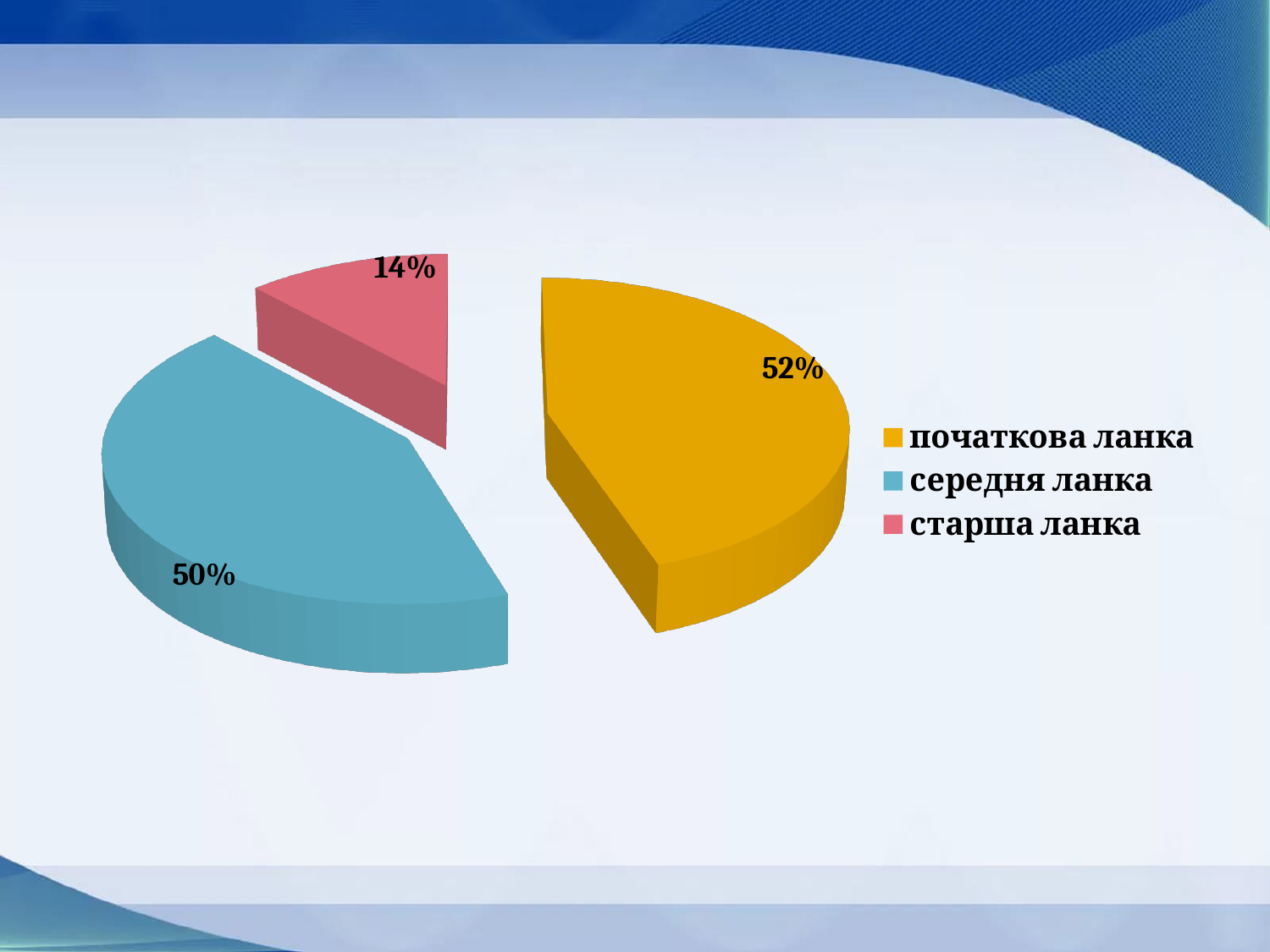
What kind of chart is shown on the slide? pie chart Which category has the smallest slice of the pie? старша ланка What percentage is shown for старша ланка? 14% What colour is the slice for старша ланка? pink How many entries does the legend list? 3 What colour is the slice for початкова ланка? yellow How many slices does the pie chart have? 3 What percentage is shown for початкова ланка? 52% What percentage is shown for середня ланка? 50% Which is larger, the slice for середня ланка or the slice for старша ланка? середня ланка What is the difference in percentage points between початкова ланка and старша ланка? 38 Which category has the largest slice of the pie? початкова ланка